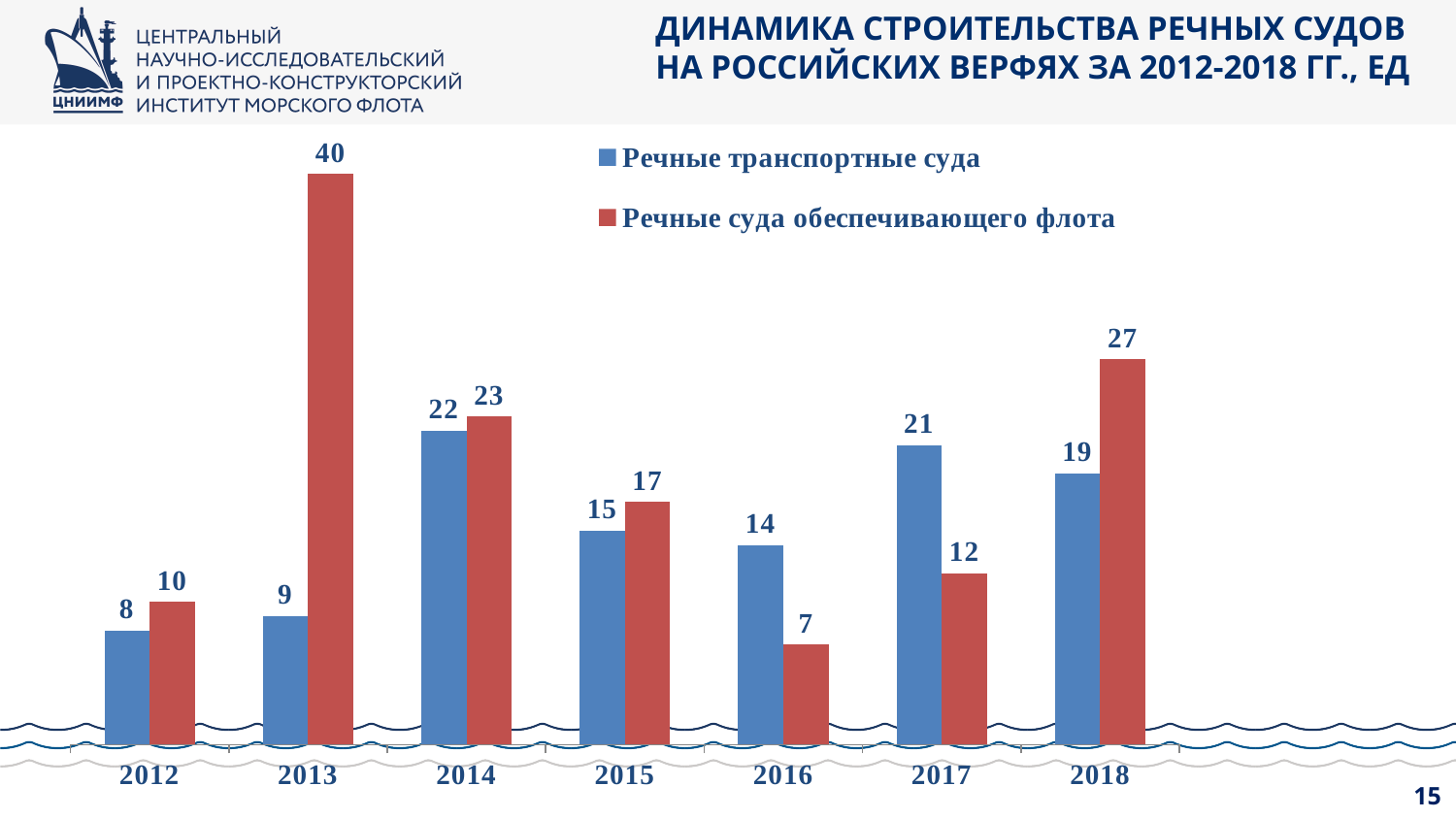
Does the value for Речные транспортные суда rise or fall from 2012 to 2014? rise How many years are shown on the x axis? 7 In which year is the value for Речные суда обеспечивающего флота the highest? 2013 What is the value for Речные транспортные суда in 2014? 22 In which year is the value for Речные транспортные суда the lowest? 2012 Which is larger in 2017: Речные транспортные суда or Речные суда обеспечивающего флота? Речные транспортные суда What kind of chart is shown on the slide? bar chart What is the value for Речные суда обеспечивающего флота in 2016? 7 How many series does the legend list? 2 What is the value for Речные суда обеспечивающего флота in 2013? 40 What is the difference between Речные суда обеспечивающего флота and Речные транспортные суда in 2018? 8 What colour are the bars for Речные суда обеспечивающего флота? red